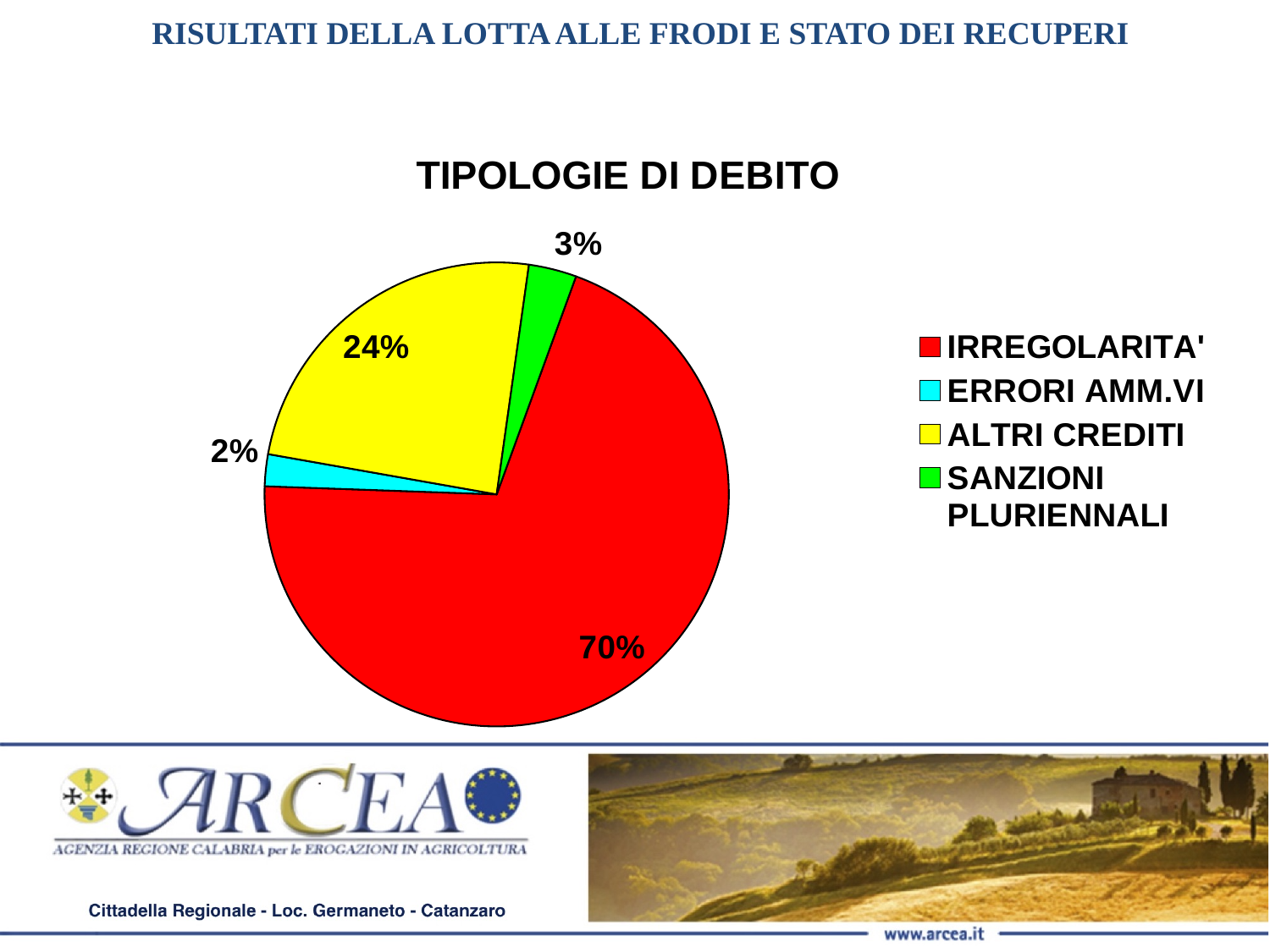
What is the difference in percentage points between IRREGOLARITA' and ALTRI CREDITI? 46 What share of the pie does ERRORI AMM.VI represent? 2% What is the title of the chart? TIPOLOGIE DI DEBITO Which category has the largest slice of the pie? IRREGOLARITA' Which category has the smallest slice of the pie? ERRORI AMM.VI How many categories does the pie chart show? 4 What share of the pie does SANZIONI PLURIENNALI represent? 3% What share of the pie does IRREGOLARITA' represent? 70% Which is larger, the share for ALTRI CREDITI or the share for SANZIONI PLURIENNALI? ALTRI CREDITI What kind of chart is shown on the slide? Pie chart What colour is the slice for ALTRI CREDITI? Yellow